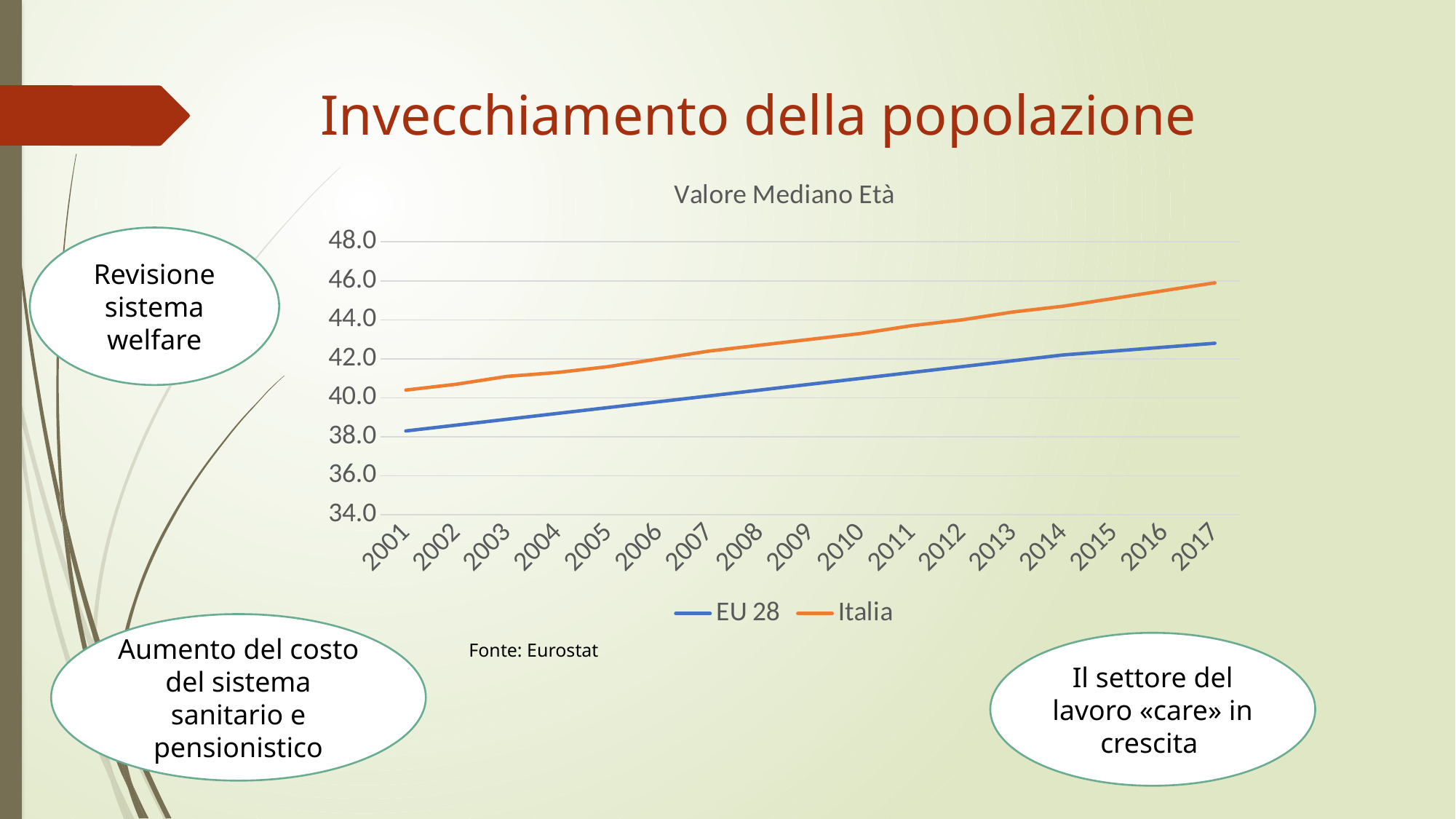
Is the value for Italia in 2001 greater or less than 42.0? less What is the title of the chart? Valore Mediano Età How many series does the legend of the chart list? 2 Does the EU 28 line rise or fall from 2001 to 2017? rise Is the value for Italia in 2017 greater or less than 44.0? greater Does the Italia line rise or fall from 2001 to 2017? rise Is the value for EU 28 in 2017 greater or less than 44.0? less In 2017, which series has the higher value, EU 28 or Italia? Italia What kind of chart is shown on the slide? line chart How many years are shown on the x axis of the chart? 17 Which series is shown in orange in the chart? Italia